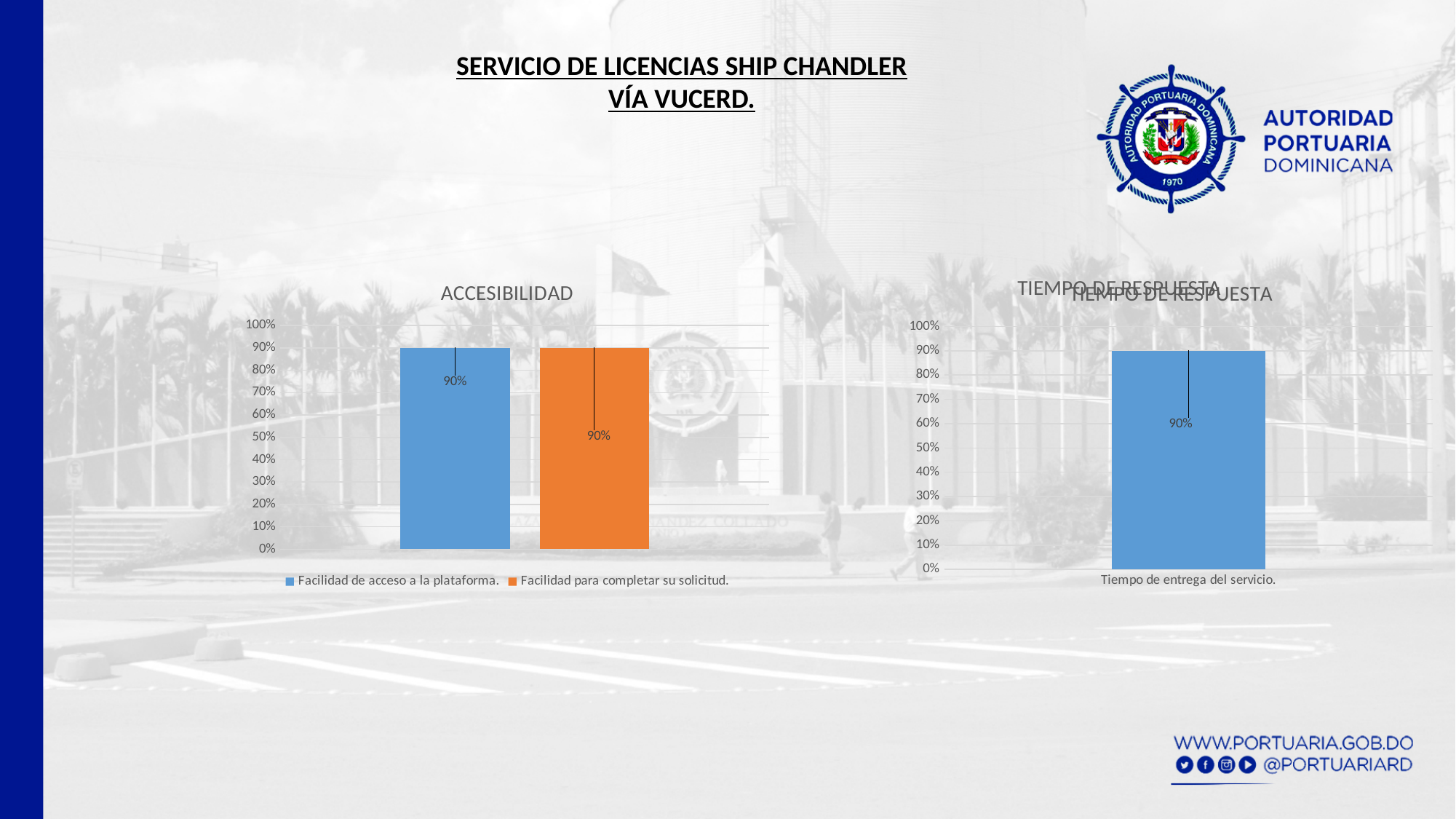
How many bars are plotted in the TIEMPO DE RESPUESTA chart? 1 In the TIEMPO DE RESPUESTA chart, what is the value for Tiempo de entrega del servicio? 90% In the TIEMPO DE RESPUESTA chart, is the value for Tiempo de entrega del servicio greater or less than 100%? less What kind of chart is the ACCESIBILIDAD chart? bar chart In the ACCESIBILIDAD chart, what is the difference between the values for Facilidad de acceso a la plataforma and Facilidad para completar su solicitud? 0% How many series does the legend of the ACCESIBILIDAD chart list? 2 In the ACCESIBILIDAD chart, what colour is the bar for Facilidad para completar su solicitud? orange In the ACCESIBILIDAD chart, what is the value for Facilidad de acceso a la plataforma? 90% What kind of chart is the TIEMPO DE RESPUESTA chart? bar chart What is the title of the chart on the left side of the slide? ACCESIBILIDAD In the ACCESIBILIDAD chart, is the value for Facilidad de acceso a la plataforma greater or less than 50%? greater In the ACCESIBILIDAD chart, what is the value for Facilidad para completar su solicitud? 90%